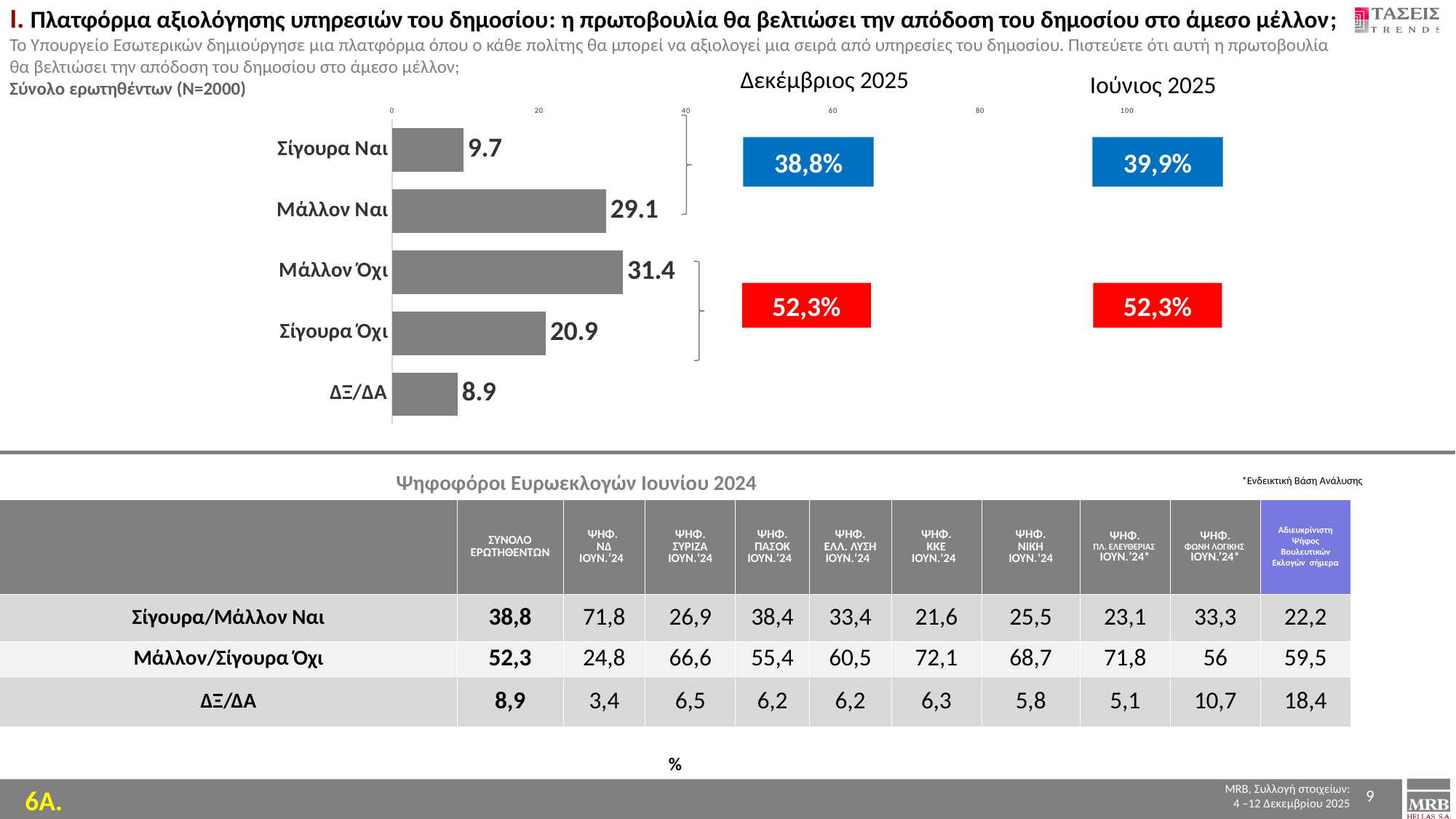
What is the difference between the values for Μάλλον Όχι and Σίγουρα Όχι? 10.5 How many categories does the bar chart show? 5 What is the value for ΔΞ/ΔΑ? 8.9 Which category has the lowest value in the bar chart? ΔΞ/ΔΑ Is the value for Μάλλον Όχι greater or less than 40? less What is the value for Μάλλον Όχι? 31.4 What is the value for Σίγουρα Όχι? 20.9 Which category has the highest value in the bar chart? Μάλλον Όχι What kind of chart is shown on the slide? bar chart What is the value for Σίγουρα Ναι? 9.7 Which is larger, the value for Μάλλον Ναι or the value for Σίγουρα Όχι? Μάλλον Ναι What is the value for Μάλλον Ναι? 29.1